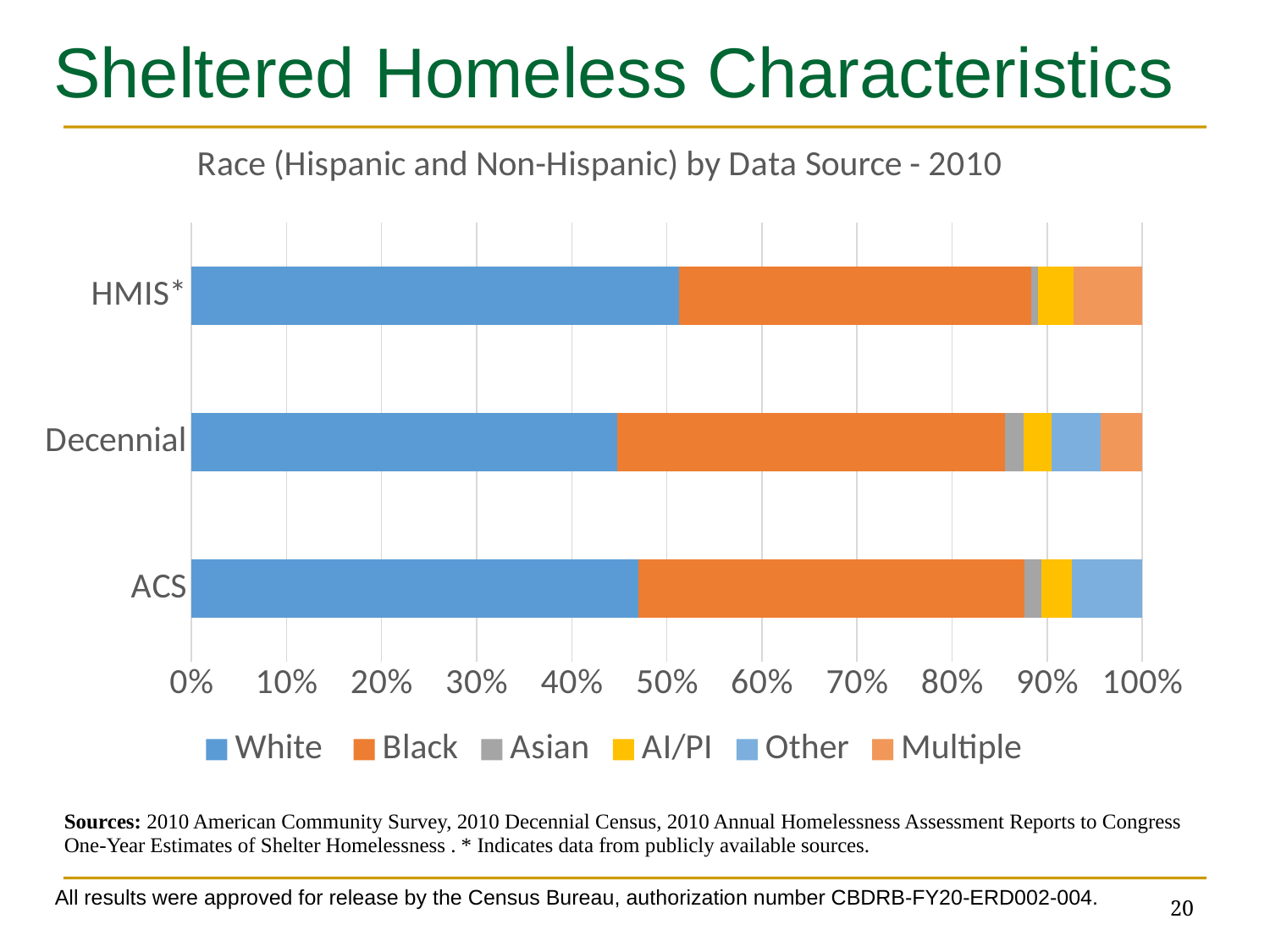
For ACS, which is larger, the White share or the Black share? White For HMIS*, which is larger, the White share or the Black share? White What is the title of the chart? Race (Hispanic and Non-Hispanic) by Data Source - 2010 Which data source has the largest Multiple share? HMIS* Is the White share for HMIS* greater or less than 50%? greater What type of chart is shown on the slide? Stacked bar chart Which data source has the largest White share? HMIS* How many data sources (categories) are plotted on the chart? 3 What does each stacked bar total on the x axis? 100% How many series does the legend list? 6 Which series is shown in yellow in the legend? AI/PI Is the White share for Decennial greater or less than 50%? less